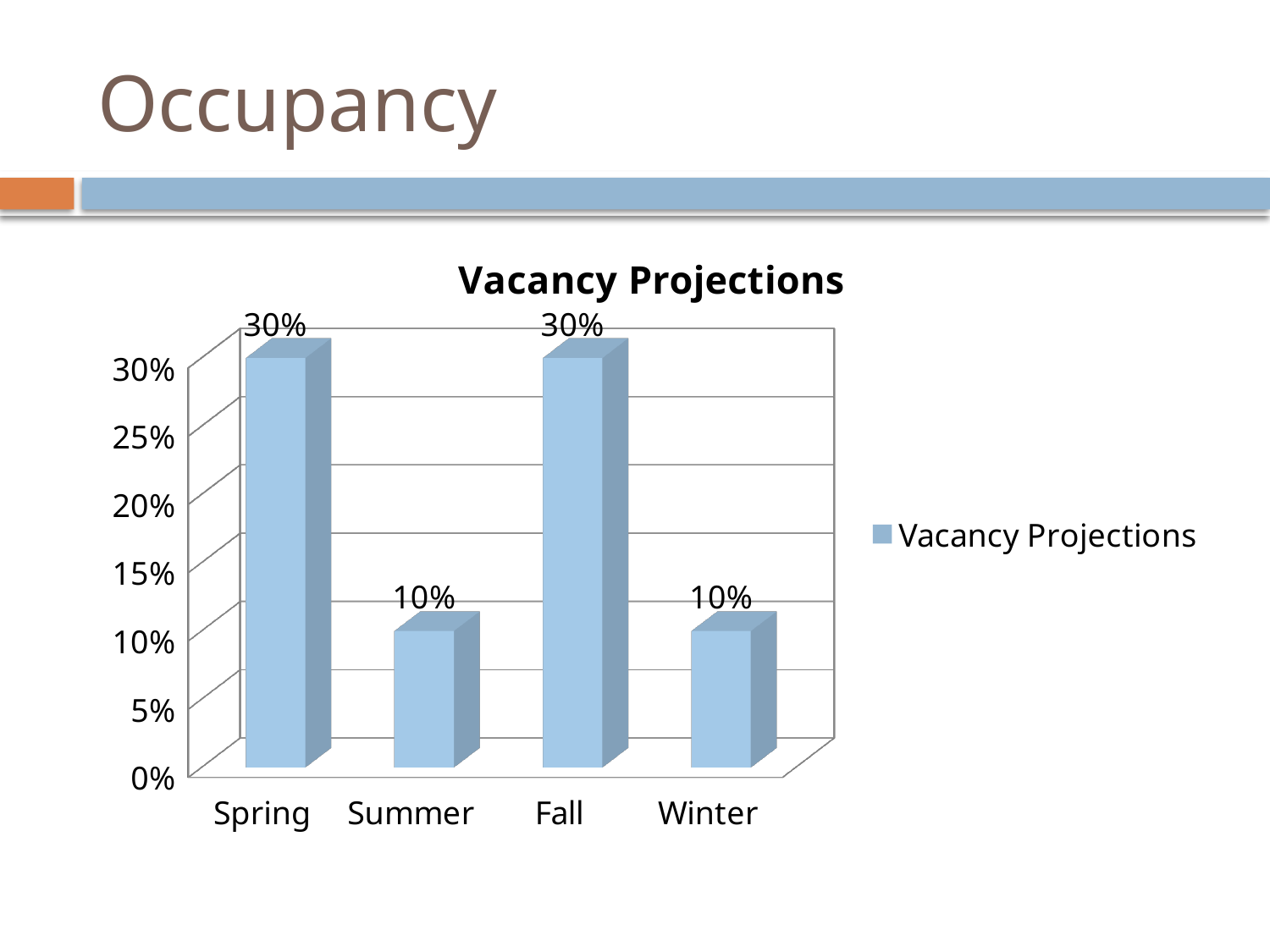
What is the title of the chart? Vacancy Projections What is the vacancy projection for Summer? 10% What is the vacancy projection for Winter? 10% What is the difference between the vacancy projections for Spring and Summer? 20% How many seasons are shown on the x axis? 4 Which is larger, the vacancy projection for Fall or for Winter? Fall Is the vacancy projection for Fall greater or less than 25%? greater Is the vacancy projection for Summer greater or less than 15%? less How many series does the legend list? 1 What kind of chart is shown on the slide? bar chart What is the vacancy projection for Spring? 30% What is the vacancy projection for Fall? 30%